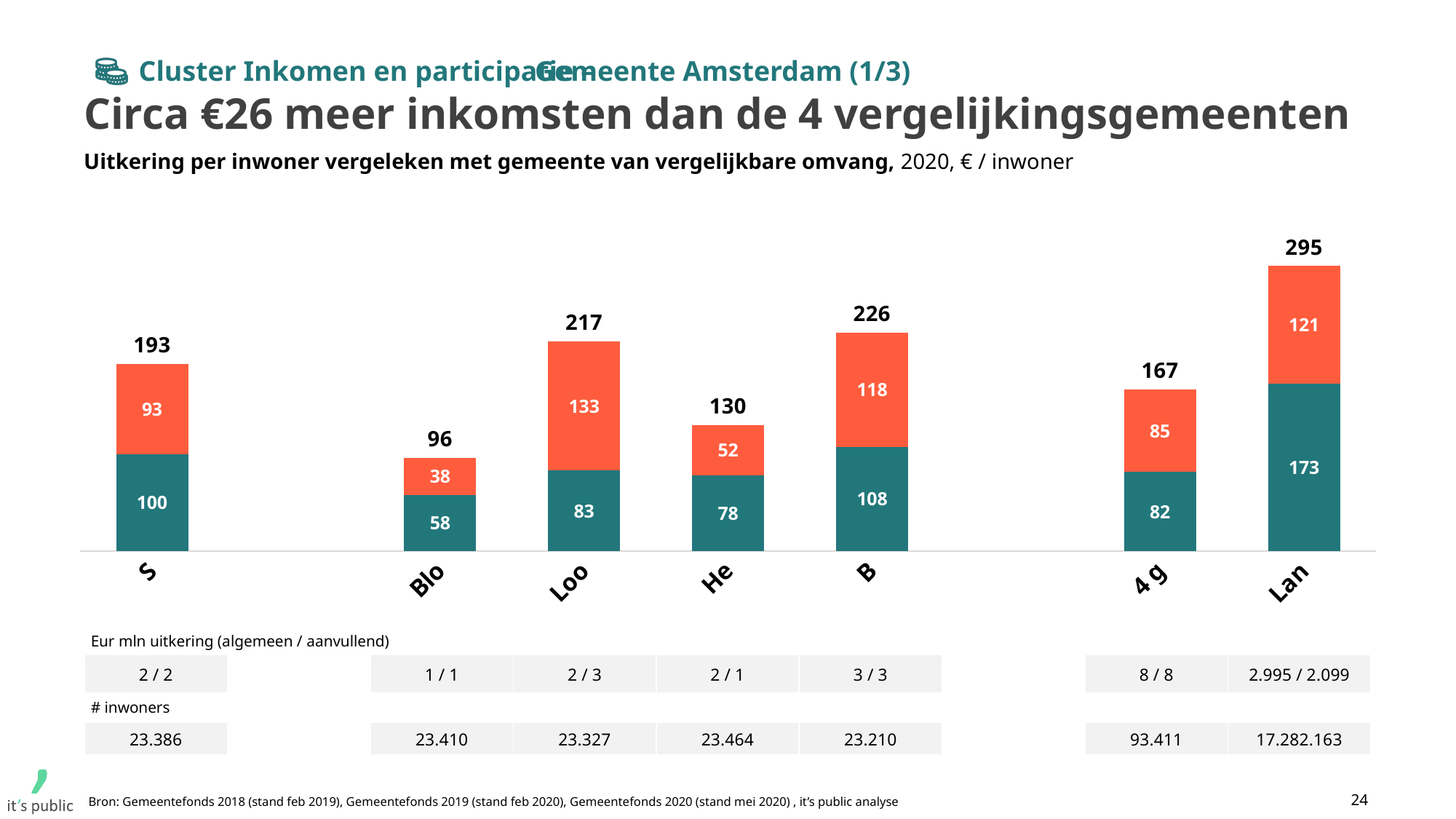
What is the value of the orange (top) segment for 'S'? 93 What is the total value printed above the bar for 'Blo'? 96 What is the value of the teal (bottom) segment for 'B'? 108 What is the total value printed above the bar for 'Lan'? 295 How many bars (categories) are plotted in the chart? 7 What is the difference between the total for 'S' (193) and the total for '4 g' (167)? 26 What unit is stated in the chart subtitle for the plotted values? € / inwoner What is the value of the orange (top) segment for 'Loo'? 133 Which has a larger total value, 'He' or 'B'? B Which category has the lowest total value? Blo What type of chart is shown on the slide? stacked bar chart Which category has the highest total value? Lan